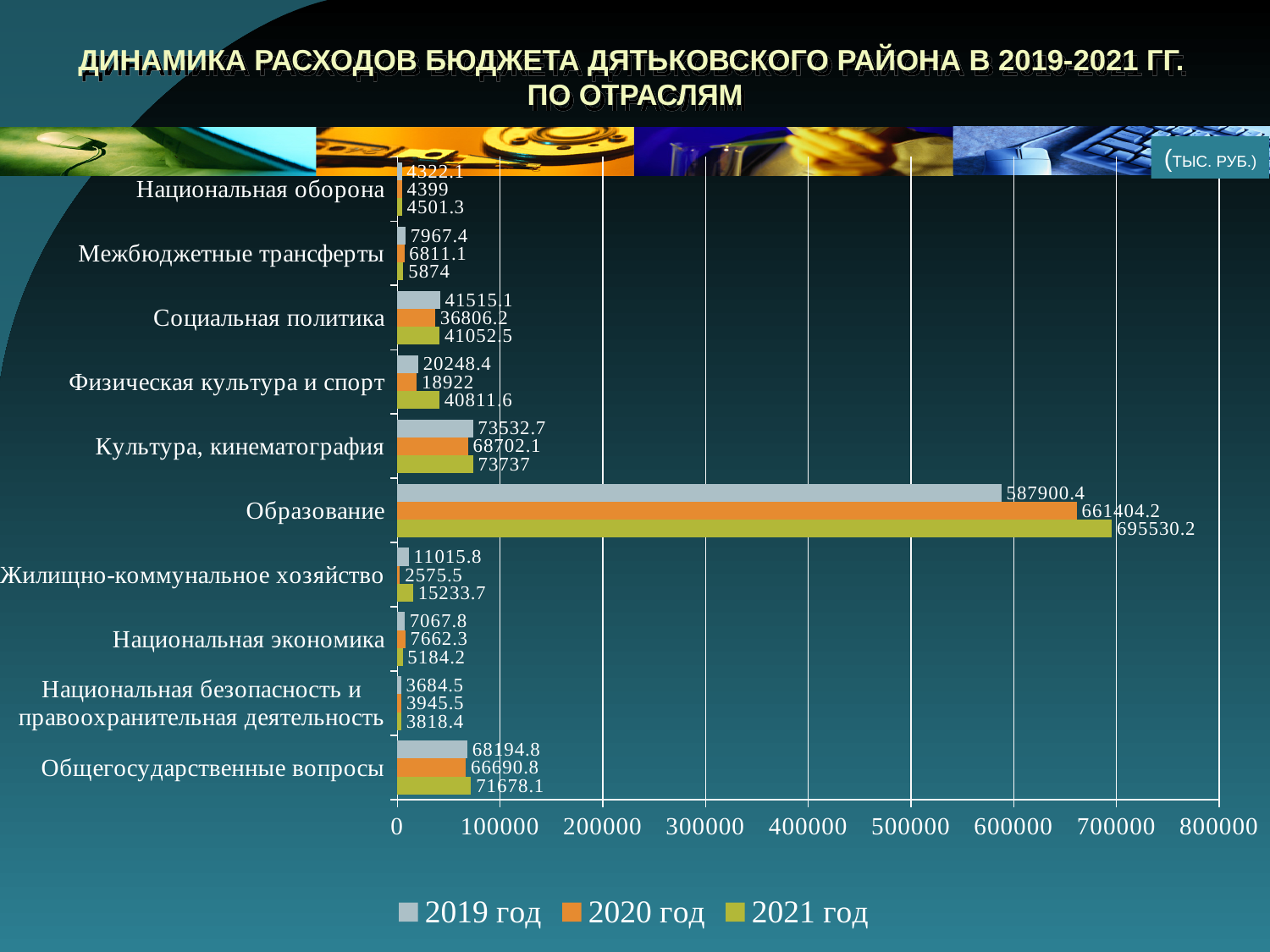
What is the value for Образование in 2021 год? 695530.2 Which is larger for Общегосударственные вопросы: the 2019 год value or the 2021 год value? 2021 год What kind of chart is shown on the slide? bar chart How many series does the legend list? 3 Which category has the lowest value in 2020 год? Жилищно-коммунальное хозяйство How many categories are shown on the chart? 10 Is the 2020 год value for Образование greater or less than 600000? greater Which category has the highest value in 2021 год? Образование What is the difference between the 2021 год and 2020 год values for Физическая культура и спорт? 21889.6 What is the value for Культура, кинематография in 2019 год? 73532.7 What is the value for Жилищно-коммунальное хозяйство in 2020 год? 2575.5 What is the difference between the 2021 год and 2019 год values for Образование? 107629.8